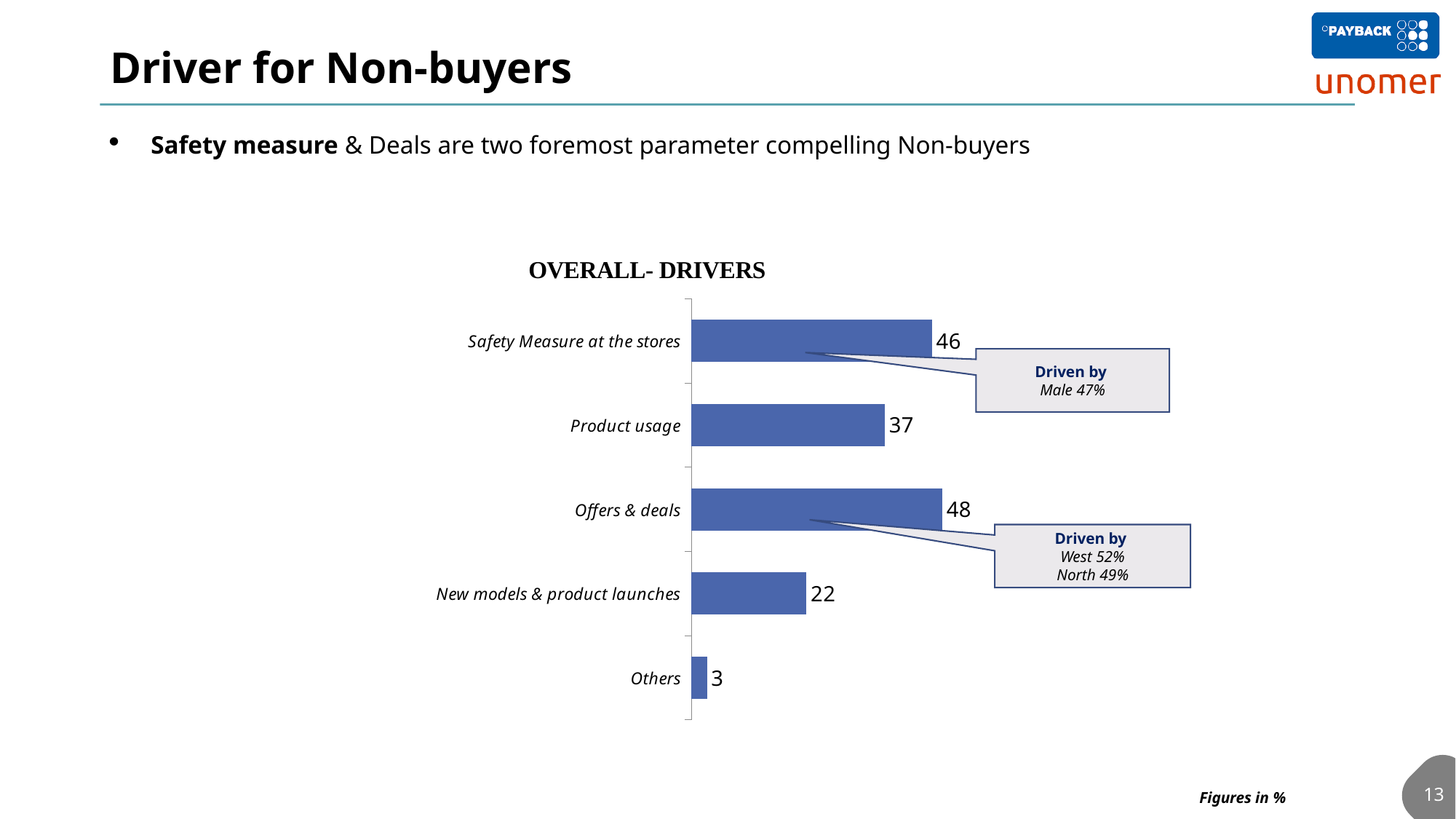
What is the value for Others? 3 What is the value for New models & product launches? 22 What is the difference between the values for Offers & deals and Safety Measure at the stores? 2 What is the title of the chart? OVERALL- DRIVERS Which category has the highest value? Offers & deals How many categories are shown in the chart? 5 What is the difference between the values for Product usage and New models & product launches? 15 What is the value for Safety Measure at the stores? 46 Which category has the lowest value? Others What kind of chart is shown on the slide? Bar chart Which is larger, the value for Product usage or the value for New models & product launches? Product usage What is the value for Product usage? 37